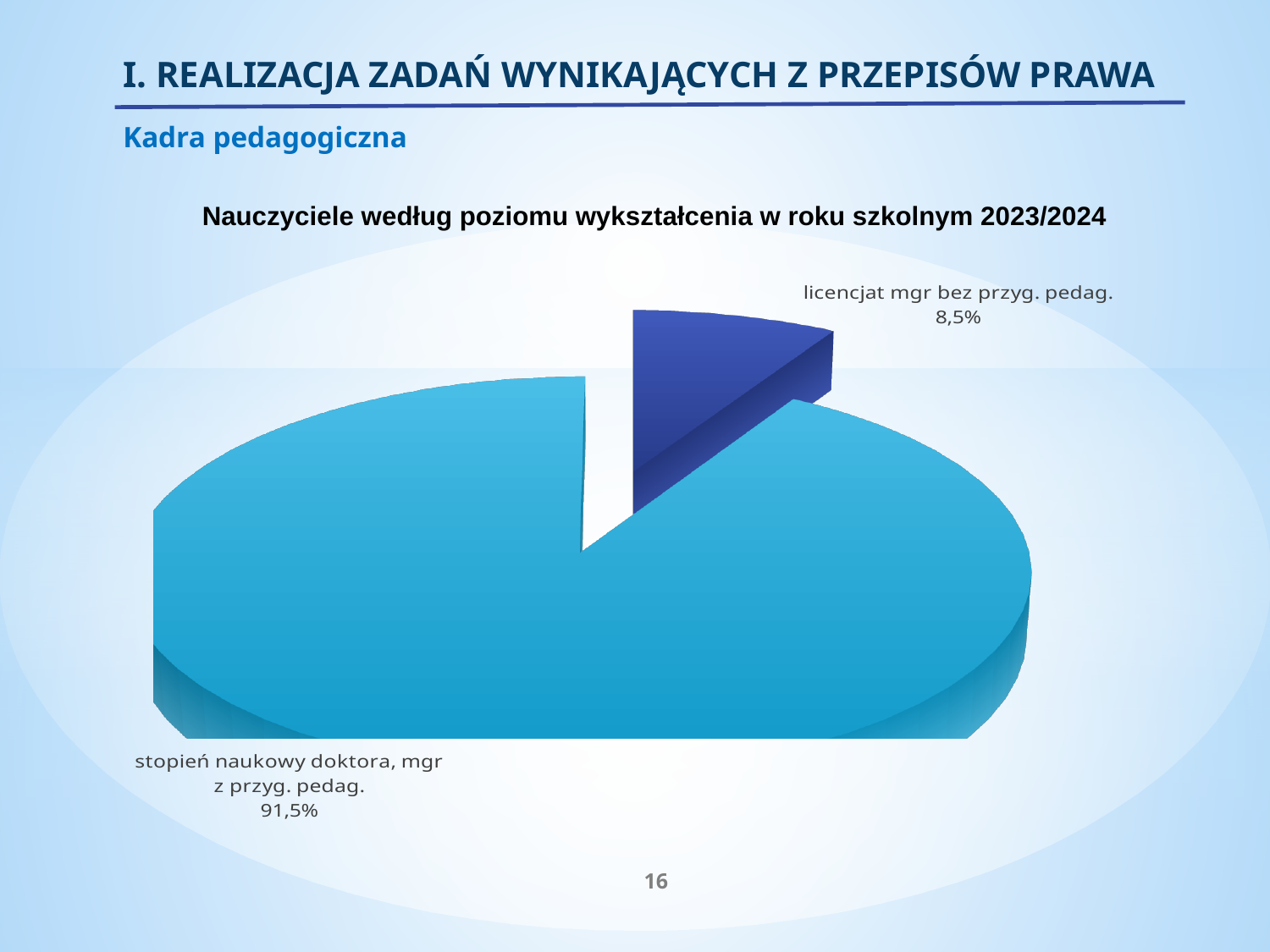
Which category has the smallest slice of the pie? licencjat mgr bez przyg. pedag. What colour is the slice for 'licencjat mgr bez przyg. pedag.'? dark blue What is the difference in percentage points between the 'stopień naukowy doktora, mgr z przyg. pedag.' slice and the 'licencjat mgr bez przyg. pedag.' slice? 83 percentage points What share of teachers have 'stopień naukowy doktora, mgr z przyg. pedag.'? 91,5% Which category has the largest slice of the pie? stopień naukowy doktora, mgr z przyg. pedag. What is the title of the chart? Nauczyciele według poziomu wykształcenia w roku szkolnym 2023/2024 What kind of chart is shown on the slide? pie chart What share of teachers have 'licencjat mgr bez przyg. pedag.'? 8,5% How many slices does the pie chart have? 2 Which is larger: the share for 'licencjat mgr bez przyg. pedag.' or the share for 'stopień naukowy doktora, mgr z przyg. pedag.'? stopień naukowy doktora, mgr z przyg. pedag.